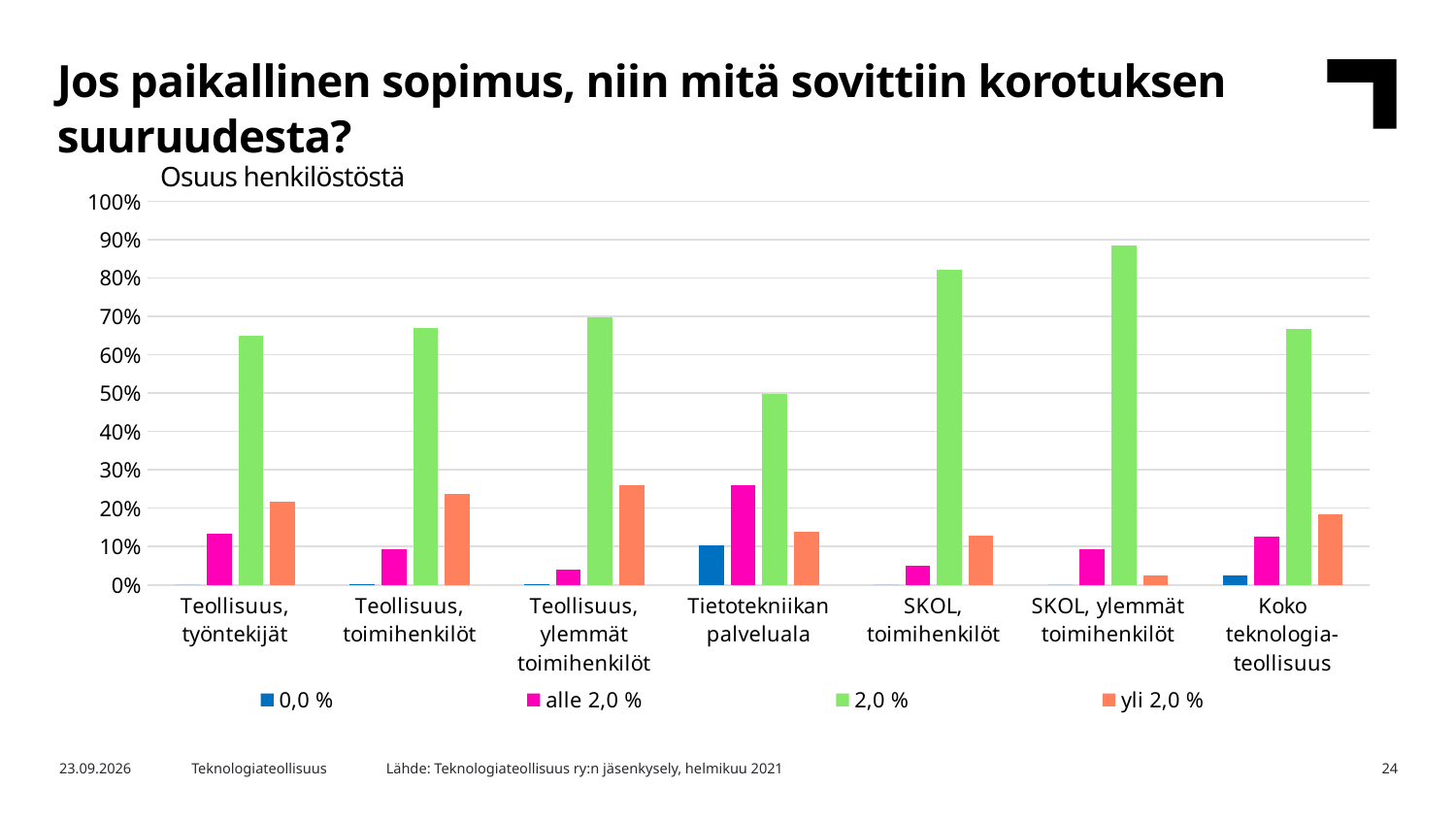
How many series does the legend list? 4 How many categories are shown on the x axis? 7 Is the alle 2,0 % value for Tietotekniikan palveluala greater or less than 20%? greater Is the 2,0 % value for Tietotekniikan palveluala greater or less than 60%? less Which category has the highest value for the alle 2,0 % series? Tietotekniikan palveluala Is the 2,0 % value for SKOL, toimihenkilöt greater or less than 70%? greater Which category has the lowest value for the 2,0 % series? Tietotekniikan palveluala What kind of chart is shown on the slide? bar chart What is the label on the vertical axis of the chart? Osuus henkilöstöstä For Tietotekniikan palveluala, which is larger: the alle 2,0 % value or the yli 2,0 % value? alle 2,0 % Which category has the highest value for the 2,0 % series? SKOL, ylemmät toimihenkilöt Which category has the lowest value for the yli 2,0 % series? SKOL, ylemmät toimihenkilöt